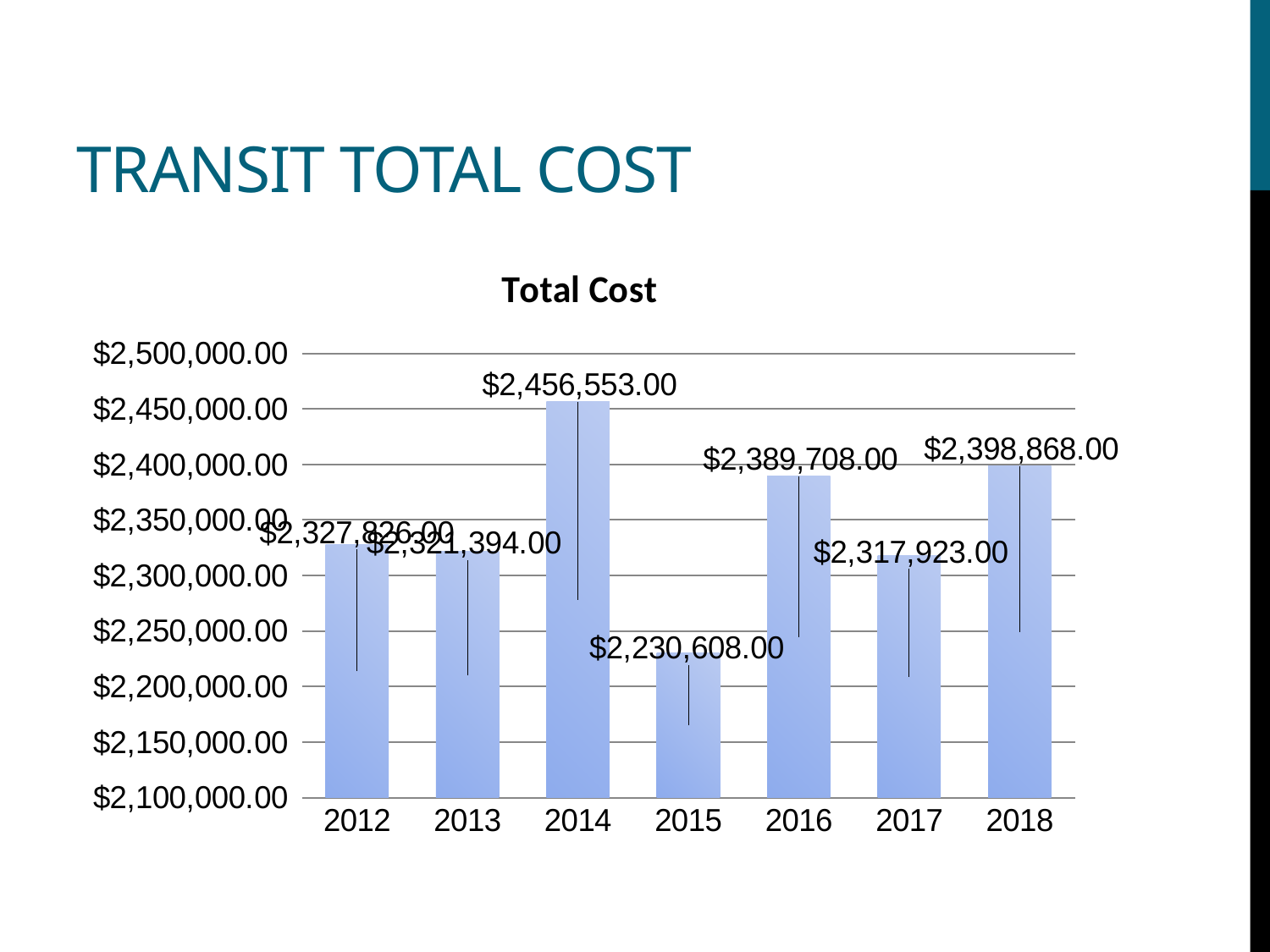
What is the Total Cost value for 2017? $2,317,923.00 How many years are shown on the x axis of the Total Cost chart? 7 What kind of chart is used to show Total Cost? bar chart From 2014 to 2015, does the Total Cost rise or fall? fall Which year has a larger Total Cost, 2014 or 2016? 2014 Is the Total Cost value for 2012 greater or less than $2,300,000.00? greater Which year has the highest Total Cost? 2014 What is the Total Cost value for 2014? $2,456,553.00 Which year has the lowest Total Cost? 2015 What is the Total Cost value for 2015? $2,230,608.00 What is the difference between the Total Cost for 2014 and 2015? $225,945.00 What is the Total Cost value for 2018? $2,398,868.00